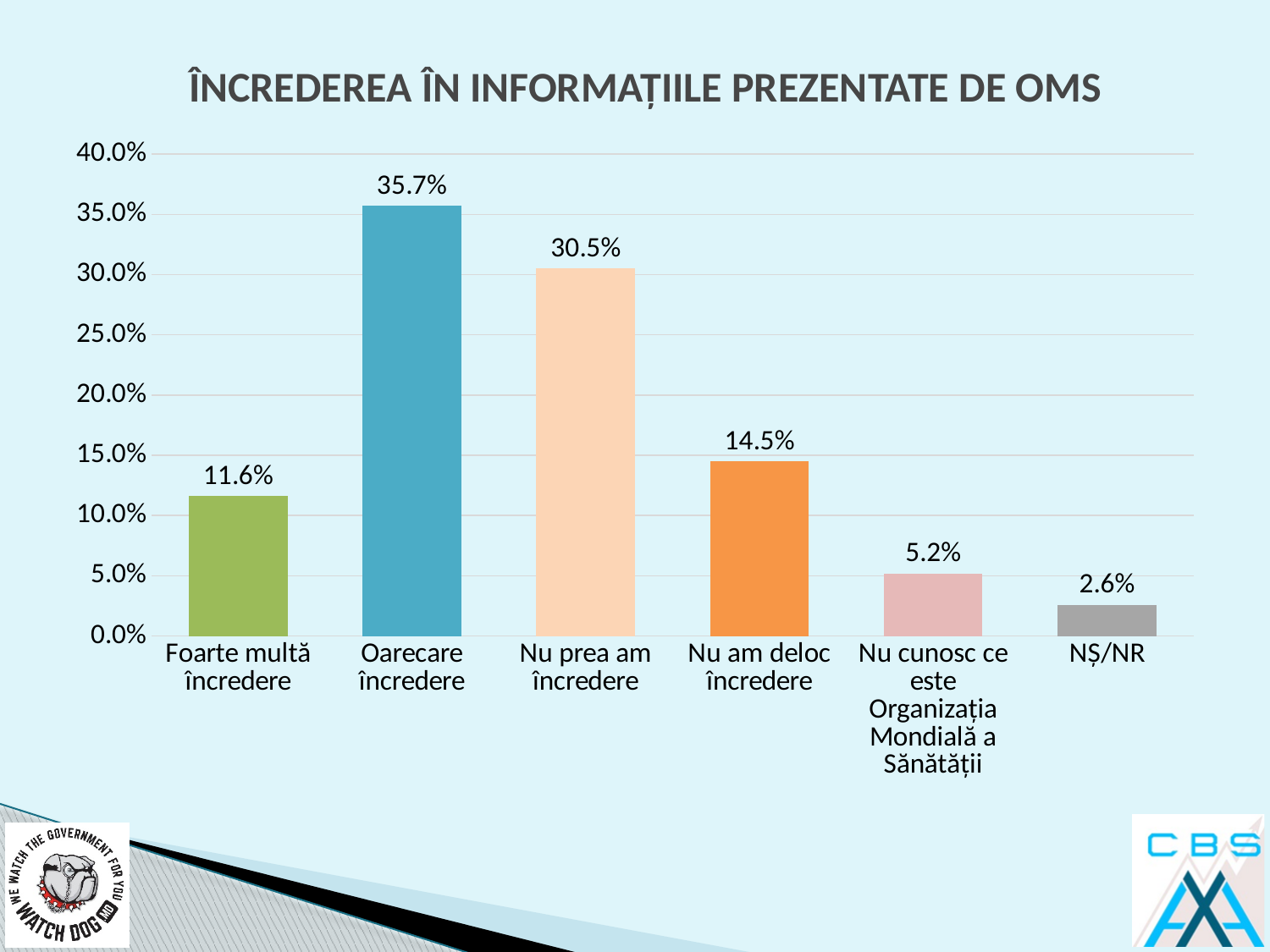
What is the difference between "Oarecare încredere" and "Nu prea am încredere"? 5.2% Is the value for "Nu prea am încredere" greater or less than 30.0%? greater What is the difference between "Nu am deloc încredere" and "Foarte multă încredere"? 2.9% What is the value for "Oarecare încredere"? 35.7% What kind of chart is shown on the slide? bar chart Which category has the lowest value? NȘ/NR Which category has the highest value? Oarecare încredere What is the value for "NȘ/NR"? 2.6% What is the value for "Nu am deloc încredere"? 14.5% What is the title of the chart? ÎNCREDEREA ÎN INFORMAȚIILE PREZENTATE DE OMS Which is larger, "Foarte multă încredere" or "Nu am deloc încredere"? Nu am deloc încredere How many categories are shown in the chart? 6